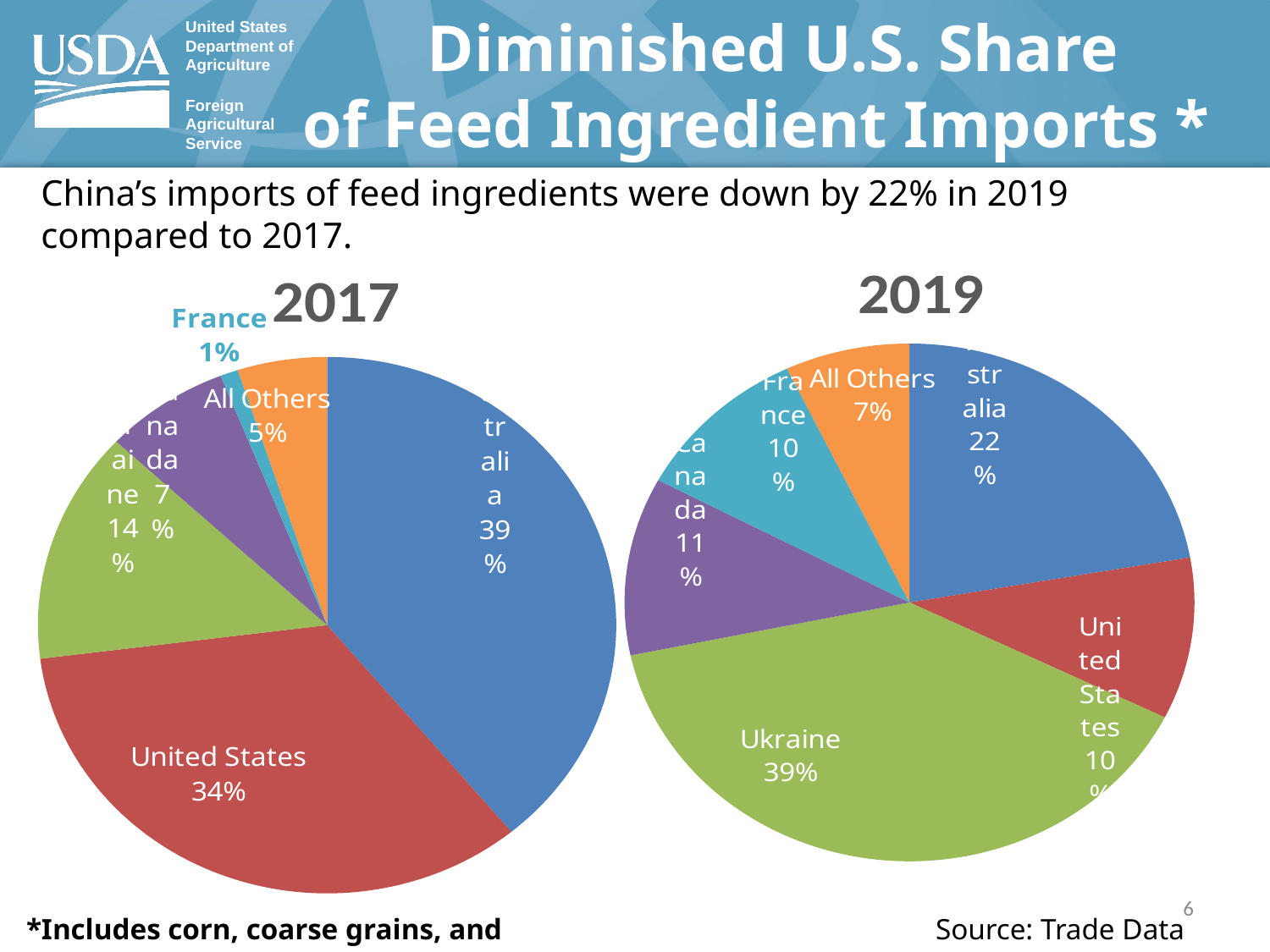
By how many percentage points did the United States share fall from the 2017 pie chart to the 2019 pie chart? 24 percentage points How many slices does the 2019 pie chart have? 6 In the 2019 pie chart, what share does Ukraine have? 39% In the 2019 pie chart, what share does All Others have? 7% In the 2017 pie chart, which category has the smallest slice? France In the 2017 pie chart, what share does United States have? 34% In the 2017 pie chart, what share does France have? 1% Is the United States share larger in the 2017 pie chart or the 2019 pie chart? 2017 In the 2019 pie chart, which category has the largest slice? Ukraine In the 2019 pie chart, what share does Canada have? 11% In the 2017 pie chart, what share does All Others have? 5% In the 2019 pie chart, what share does United States have? 10%